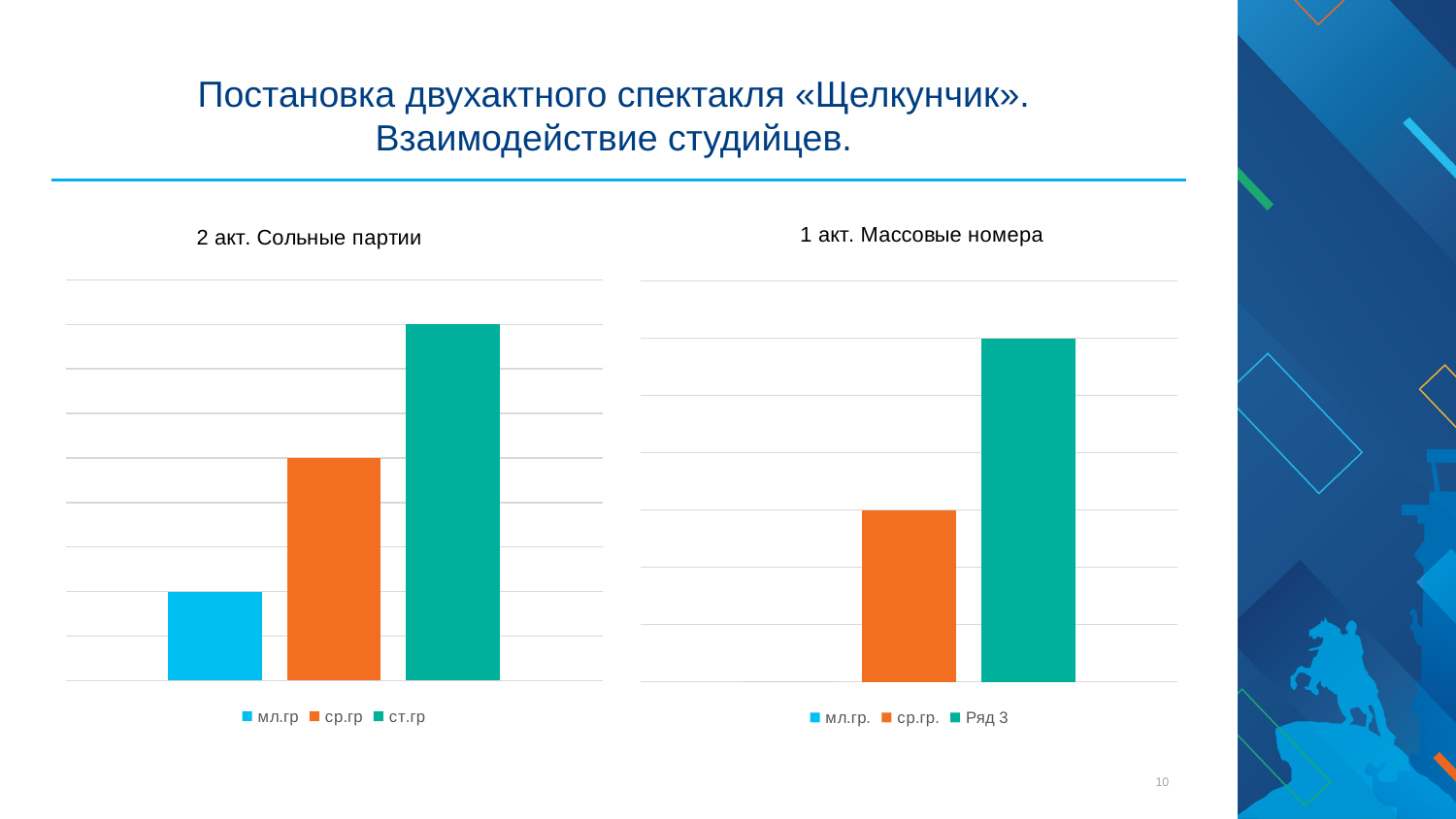
What kind of chart is the chart titled "1 акт. Массовые номера"? bar chart In the chart titled "1 акт. Массовые номера", what colour is the bar for ср.гр.? orange What is the title of the chart on the left side of the slide? 2 акт. Сольные партии In the chart titled "2 акт. Сольные партии", which series has the tallest bar? ст.гр In the chart titled "2 акт. Сольные партии", which series has the shortest bar? мл.гр How many series does the legend of the chart titled "2 акт. Сольные партии" list? 3 What kind of chart is the chart titled "2 акт. Сольные партии"? bar chart In the chart titled "1 акт. Массовые номера", which series has the tallest bar? Ряд 3 In the chart titled "1 акт. Массовые номера", which bar is taller: ср.гр. or Ряд 3? Ряд 3 How many series does the legend of the chart titled "1 акт. Массовые номера" list? 3 In the chart titled "2 акт. Сольные партии", which bar is taller: ср.гр or ст.гр? ст.гр In the chart titled "2 акт. Сольные партии", which bar is taller: мл.гр or ср.гр? ср.гр